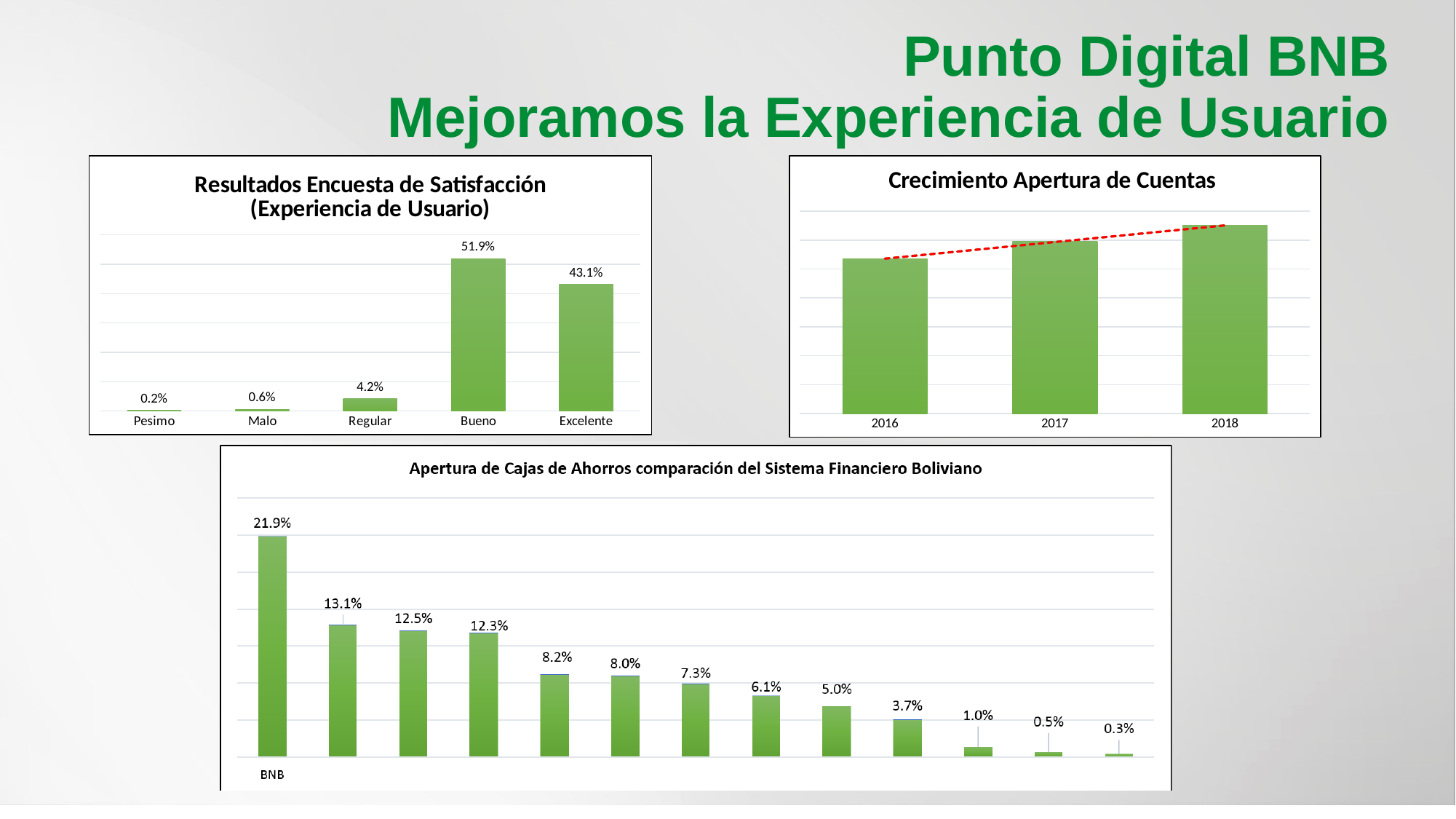
In the chart titled 'Apertura de Cajas de Ahorros comparación del Sistema Financiero Boliviano', what is the value for BNB? 21.9% In the chart titled 'Resultados Encuesta de Satisfacción (Experiencia de Usuario)', what is the value for Excelente? 43.1% In the chart titled 'Resultados Encuesta de Satisfacción (Experiencia de Usuario)', what is the difference between the values for Bueno and Excelente? 8.8% In the chart titled 'Resultados Encuesta de Satisfacción (Experiencia de Usuario)', how many categories are shown? 5 In the chart titled 'Apertura de Cajas de Ahorros comparación del Sistema Financiero Boliviano', how many bars are shown? 13 In the chart titled 'Crecimiento Apertura de Cuentas', do the values rise or fall from 2016 to 2018? rise What kind of chart is 'Apertura de Cajas de Ahorros comparación del Sistema Financiero Boliviano'? bar chart In the chart titled 'Resultados Encuesta de Satisfacción (Experiencia de Usuario)', what is the value for Bueno? 51.9% In the chart titled 'Resultados Encuesta de Satisfacción (Experiencia de Usuario)', which category has the lowest value? Pesimo In the chart titled 'Crecimiento Apertura de Cuentas', which year has the highest bar? 2018 In the chart titled 'Crecimiento Apertura de Cuentas', how many years are shown? 3 In the chart titled 'Resultados Encuesta de Satisfacción (Experiencia de Usuario)', which category has the highest value? Bueno